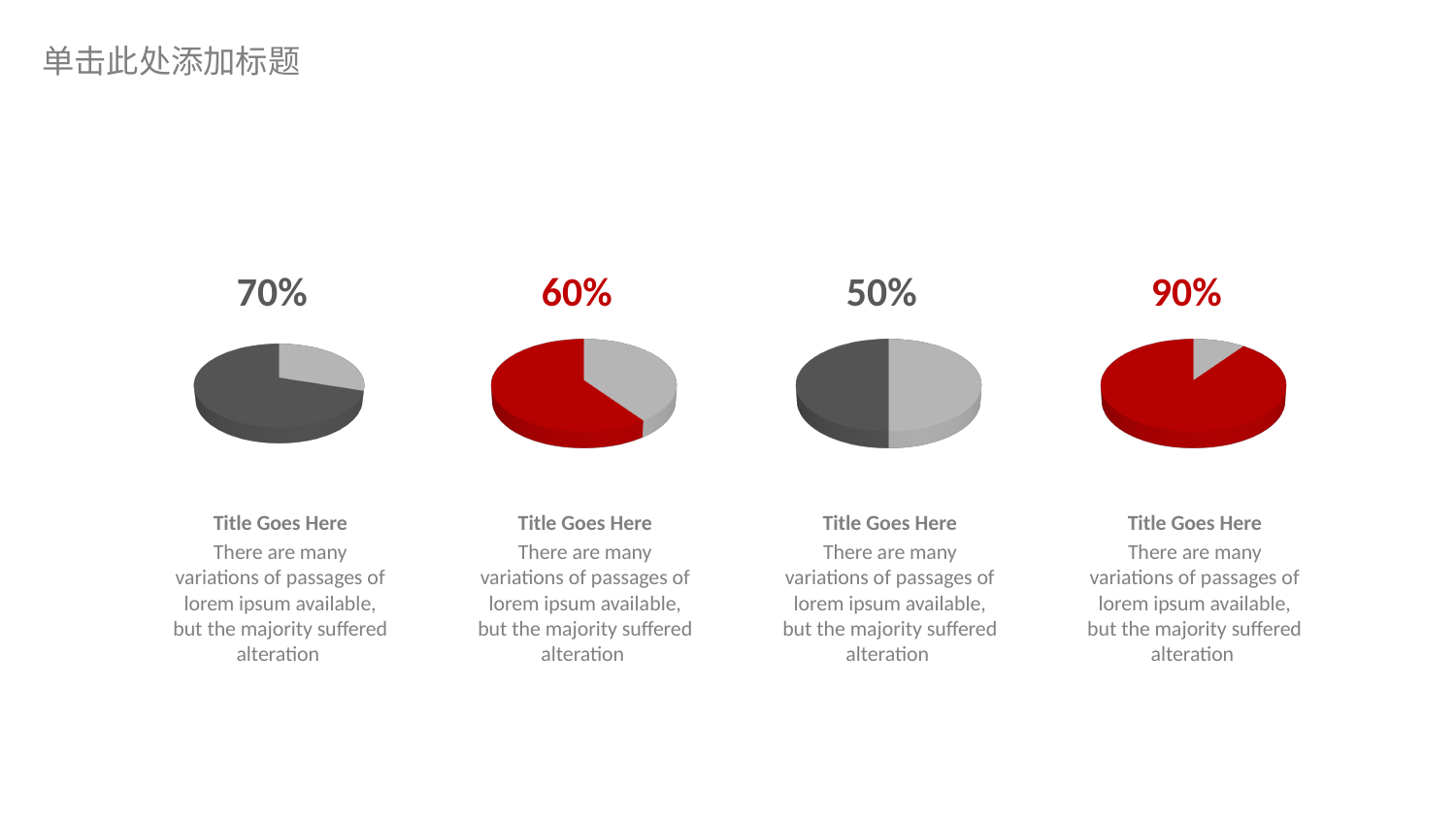
What percentage is shown above the rightmost pie chart? 90% Which pie chart on the slide shows the highest percentage? The rightmost pie chart (90%) What percentage is shown above the second pie chart from the left? 60% What is the difference between the percentage above the rightmost pie chart and the percentage above the leftmost pie chart? 20% What percentage is shown above the leftmost pie chart? 70% What kind of chart is used for each of the four figures on the slide? Pie chart Which is larger: the percentage above the leftmost pie chart or the percentage above the second pie chart from the left? The leftmost pie chart (70%) What colour is the large slice in the rightmost pie chart? Red In the third pie chart from the left, what share of the pie does the dark grey slice take up? 50% Which pie chart on the slide shows the lowest percentage? The third pie chart from the left (50%) How many pie charts are shown on the slide? 4 What percentage is shown above the third pie chart from the left? 50%